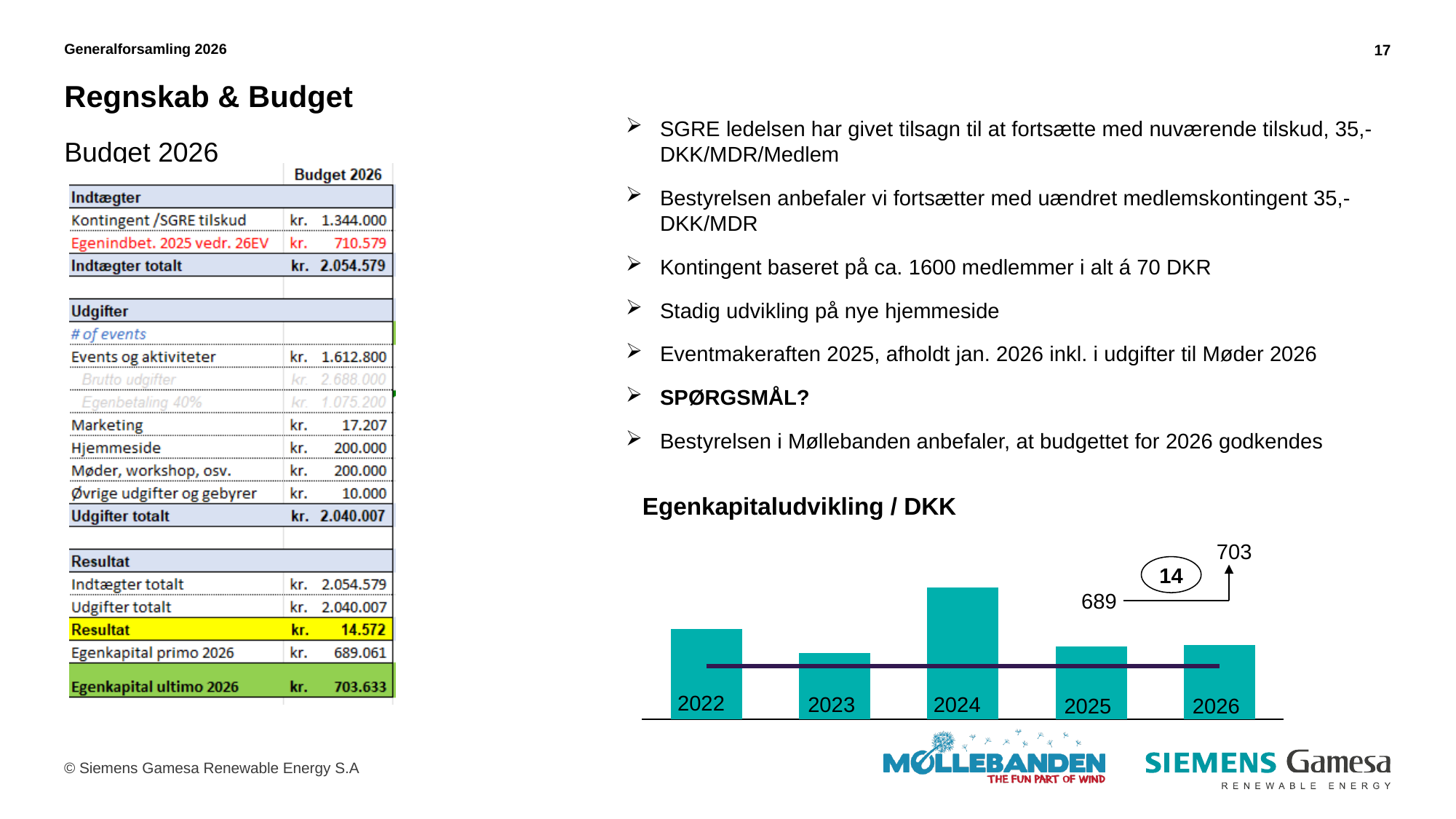
In the Egenkapitaludvikling / DKK chart, which year has the tallest bar? 2024 In the Egenkapitaludvikling / DKK chart, which is larger, the value for 2025 or the value for 2026? 2026 In the Egenkapitaludvikling / DKK chart, which year has the shortest bar? 2023 In the Egenkapitaludvikling / DKK chart, what value is labelled for 2026? 703 In the Egenkapitaludvikling / DKK chart, what is the difference between the 2026 value and the 2025 value? 14 In the Egenkapitaludvikling / DKK chart, which bar is taller, 2022 or 2023? 2022 How many years are plotted in the Egenkapitaludvikling / DKK chart? 5 In the Egenkapitaludvikling / DKK chart, which bar is taller, 2024 or 2025? 2024 In the Egenkapitaludvikling / DKK chart, does the value rise or fall from 2025 to 2026? rise What kind of chart is shown under the heading "Egenkapitaludvikling / DKK"? bar chart In the Egenkapitaludvikling / DKK chart, what value is labelled for 2025? 689 What is the title shown above the bar chart on the slide? Egenkapitaludvikling / DKK